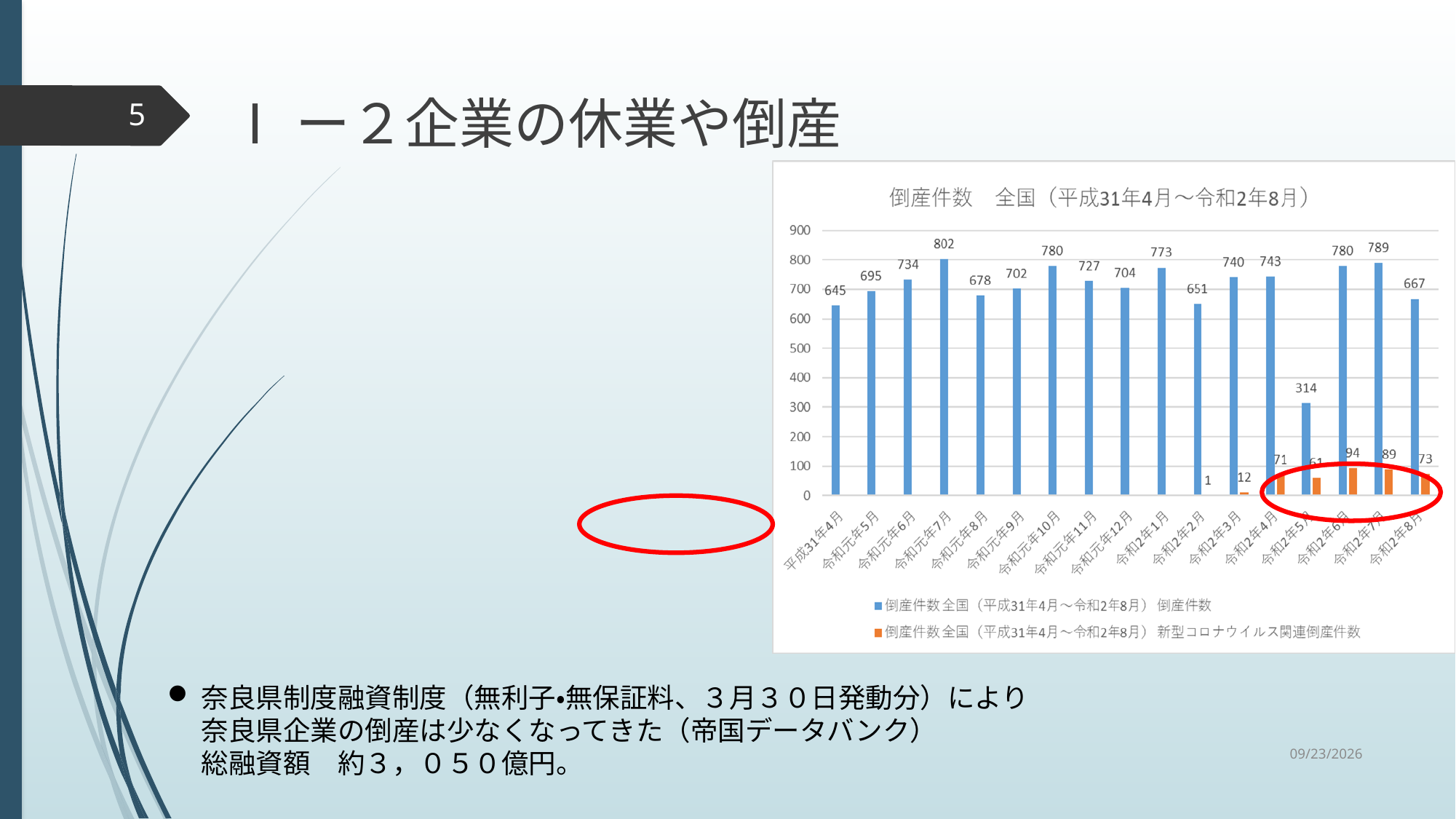
What is the number of COVID-19-related bankruptcies (新型コロナウイルス関連倒産件数) for 令和2年6月? 94 How many series does the legend list? 2 What is the total number of bankruptcies (倒産件数) for 令和元年7月? 802 Is the total number of bankruptcies for 令和2年2月 greater or less than 700? less What type of chart is shown on the slide? bar chart What is the title of the chart? 倒産件数 全国（平成31年4月～令和2年8月） Which month has the lowest total number of bankruptcies (blue series)? 令和2年5月 What is the difference between the total bankruptcies in 令和2年7月 and 令和2年5月? 475 How many months (categories) are shown on the x axis? 17 Which is larger, the total bankruptcies in 令和元年10月 or in 令和2年8月? 令和元年10月 Which month has the highest total number of bankruptcies (blue series)? 令和元年7月 What is the number of COVID-19-related bankruptcies for 令和2年3月? 12